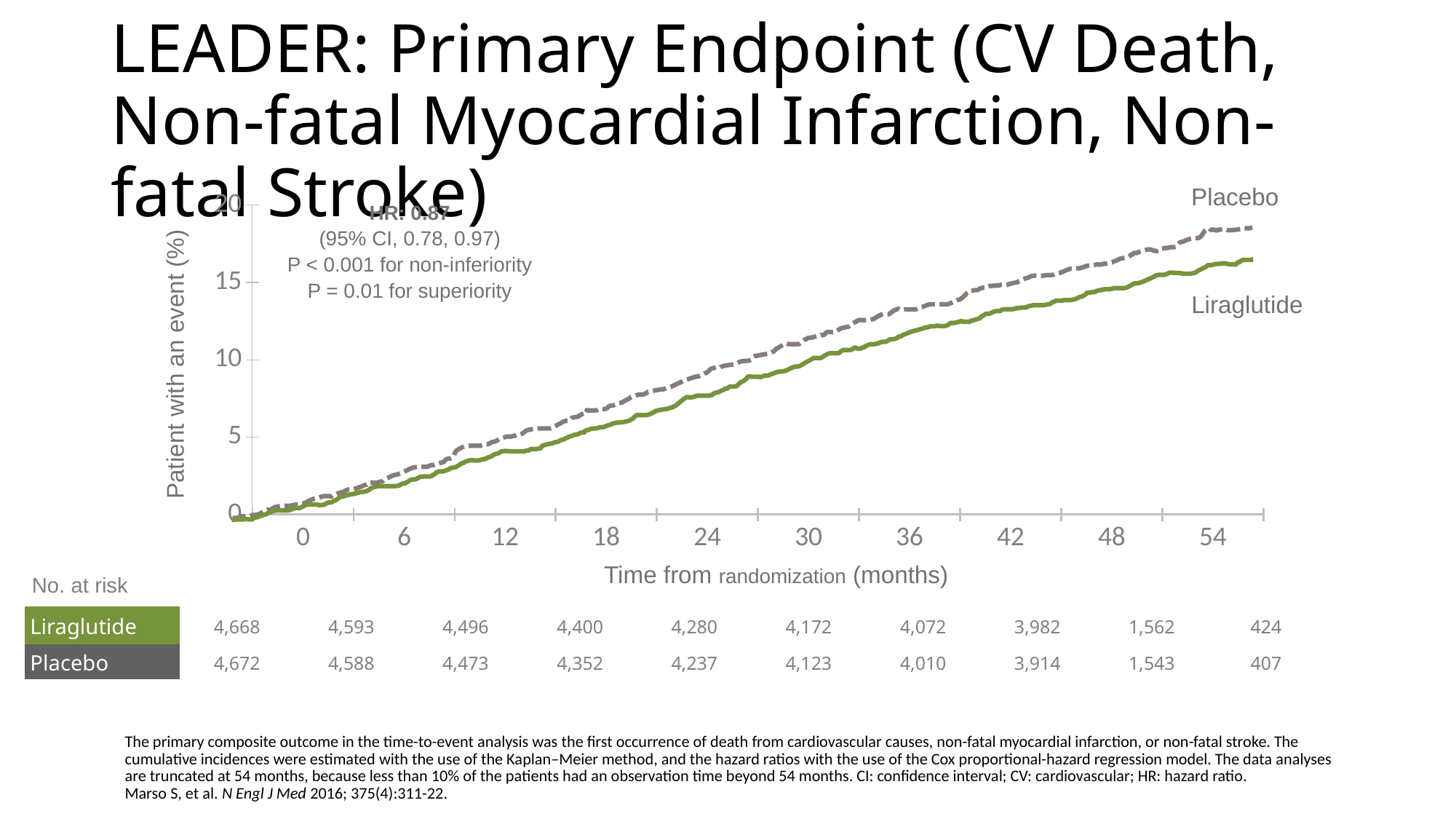
What is the label of the y axis? Patient with an event (%) Do the curves rise or fall as time from randomization increases? rise Is the value for Liraglutide at 24 months greater or less than 10? less In the 'No. at risk' table, what is the difference between the Placebo and Liraglutide numbers at risk at 0 months? 4 Is the value for Placebo at 54 months greater or less than 15? greater What kind of chart is shown on the slide? line chart What hazard ratio (HR) is reported on the chart? 0.87 In the 'No. at risk' table, how many Placebo patients were at risk at 54 months? 407 Is the value for Placebo at 36 months greater or less than 10? greater At 54 months, which group has the higher percentage of patients with an event, Placebo or Liraglutide? Placebo How many series (treatment groups) are plotted on the chart? 2 In the 'No. at risk' table, how many Liraglutide patients were at risk at 0 months? 4,668